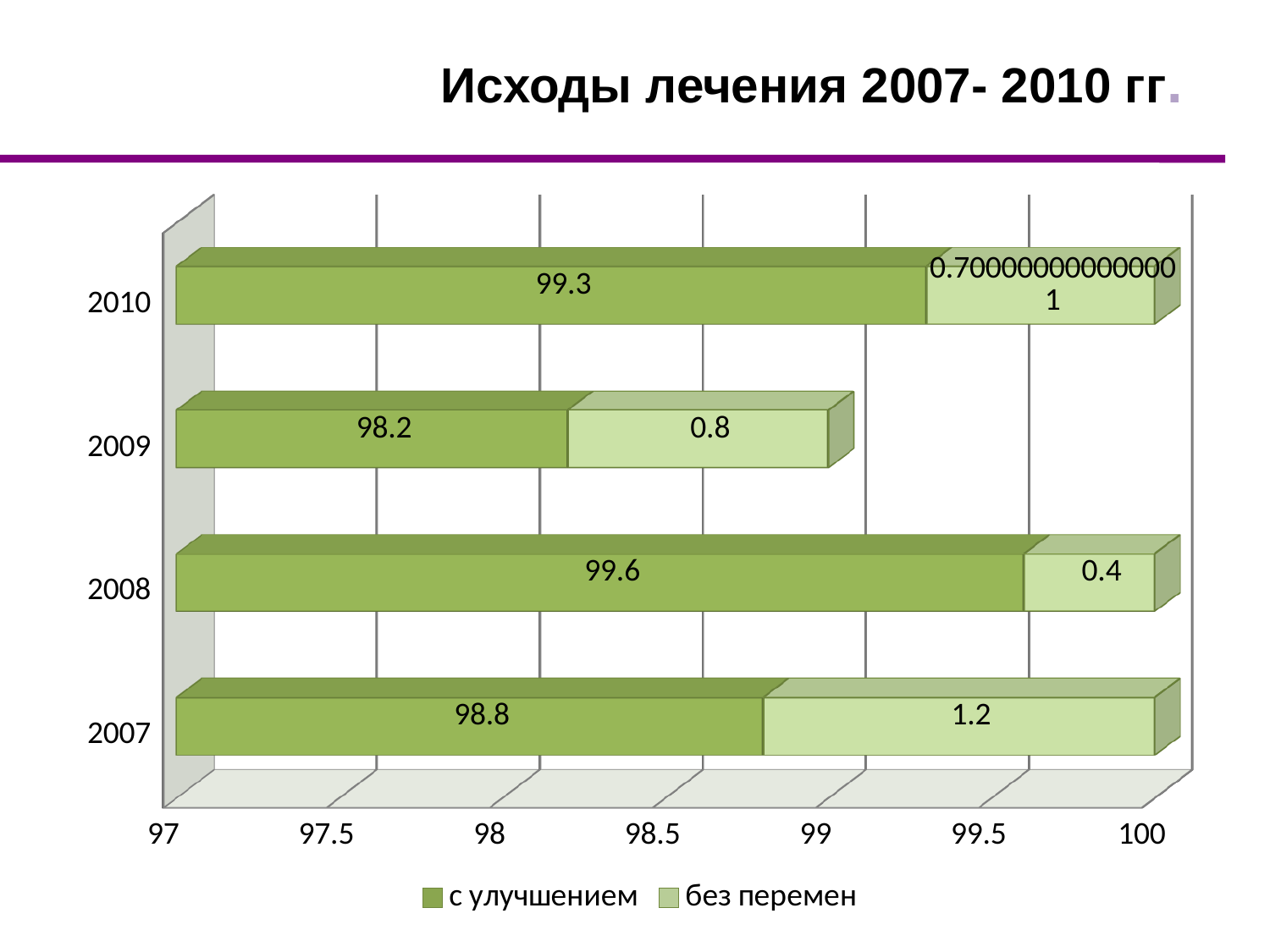
What is the value for "с улучшением" in 2008? 99.6 What is the value for "без перемен" in 2007? 1.2 What is the title of the chart? Исходы лечения 2007- 2010 гг. What kind of chart is shown on the slide? Stacked bar chart What is the total of the stacked bar for 2009? 99 Which year has the highest value for "с улучшением"? 2008 What is the value for "с улучшением" in 2009? 98.2 Which year has the lowest value for "без перемен"? 2008 How many years are shown on the chart? 4 What is the difference between the "с улучшением" values for 2008 and 2009? 1.4 Which is larger: the "без перемен" value for 2007 or for 2009? 2007 How many series does the legend list? 2